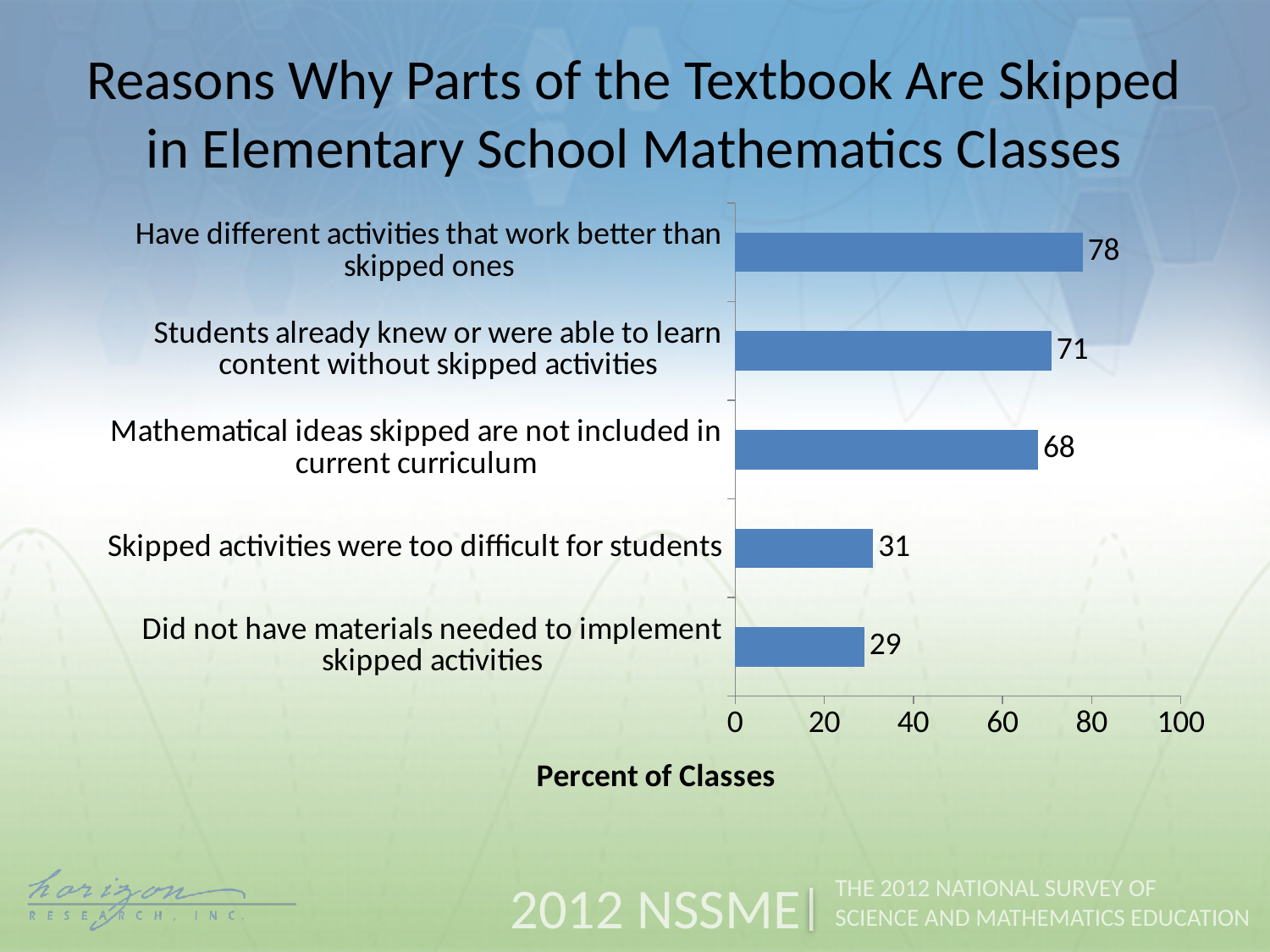
Which reason has the lowest percent of classes? Did not have materials needed to implement skipped activities What percent of classes reported "Did not have materials needed to implement skipped activities"? 29 What is the difference between the values for "Students already knew or were able to learn content without skipped activities" and "Mathematical ideas skipped are not included in current curriculum"? 3 What is the value for "Skipped activities were too difficult for students"? 31 Which reason has the highest percent of classes? Have different activities that work better than skipped ones What is the label of the horizontal axis? Percent of Classes What kind of chart is shown on the slide? Bar chart How many reasons are shown in the chart? 5 Is the value for "Mathematical ideas skipped are not included in current curriculum" greater or less than 60? greater What is the difference between the highest and lowest values in the chart? 49 Which is larger: the value for "Skipped activities were too difficult for students" or "Did not have materials needed to implement skipped activities"? Skipped activities were too difficult for students What percent of classes cited "Have different activities that work better than skipped ones" as a reason? 78